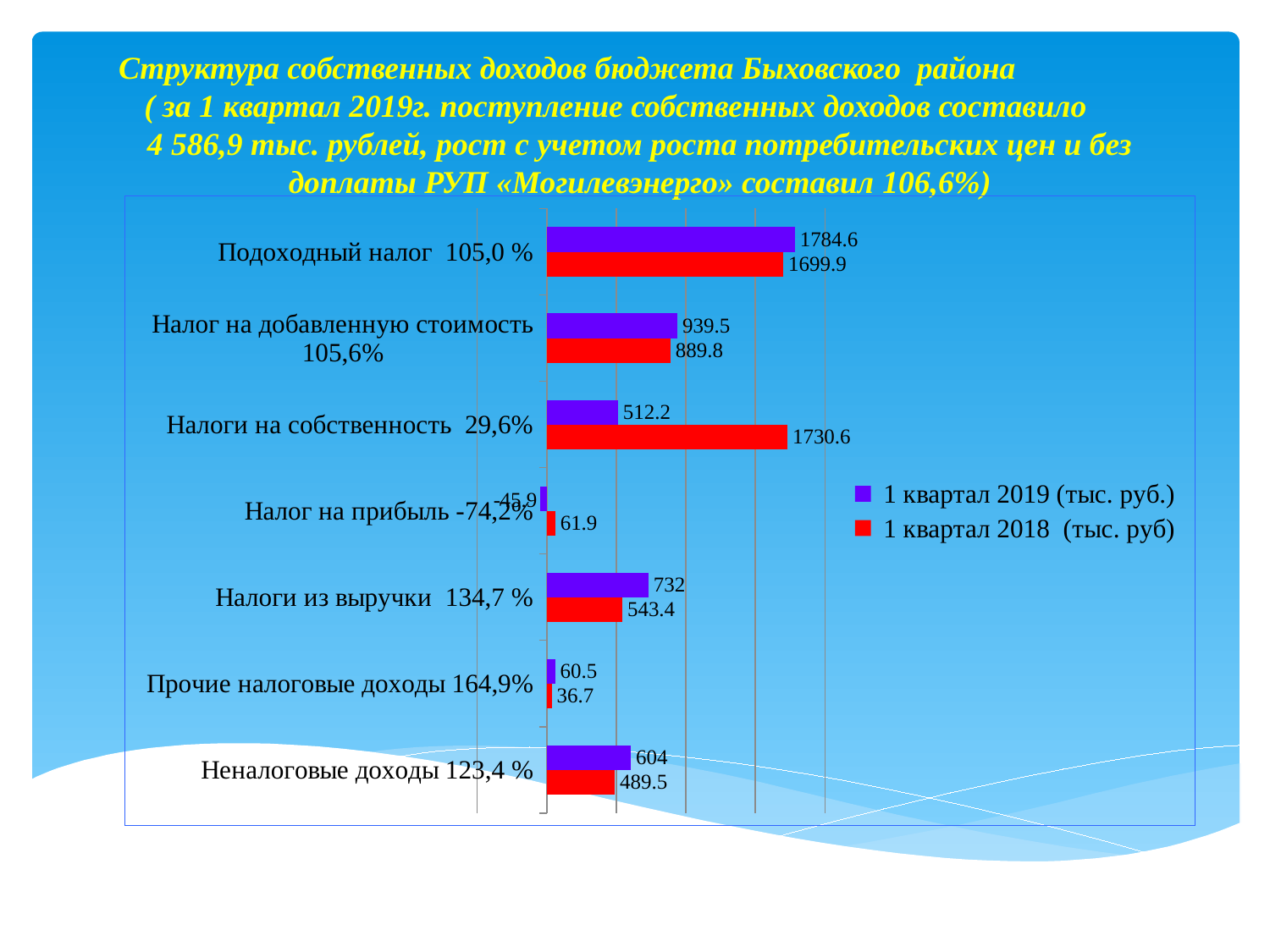
How many categories are plotted on the chart? 7 What is the value for Налоги на собственность in the 1 квартал 2018 series? 1730.6 Which colour represents the 1 квартал 2018 series in the legend? red What is the value for Неналоговые доходы in the 1 квартал 2019 series? 604 What is the value for Подоходный налог in the 1 квартал 2019 series? 1784.6 Which category has the lowest value in the 1 квартал 2018 series? Прочие налоговые доходы What kind of chart is shown on the slide? bar chart Which category has the highest value in the 1 квартал 2019 series? Подоходный налог What is the value for Прочие налоговые доходы in the 1 квартал 2018 series? 36.7 How many series does the legend list? 2 For Налоги на собственность, which series has the larger value: 1 квартал 2019 or 1 квартал 2018? 1 квартал 2018 What is the difference between the 1 квартал 2019 and 1 квартал 2018 values for Налоги из выручки? 188.6